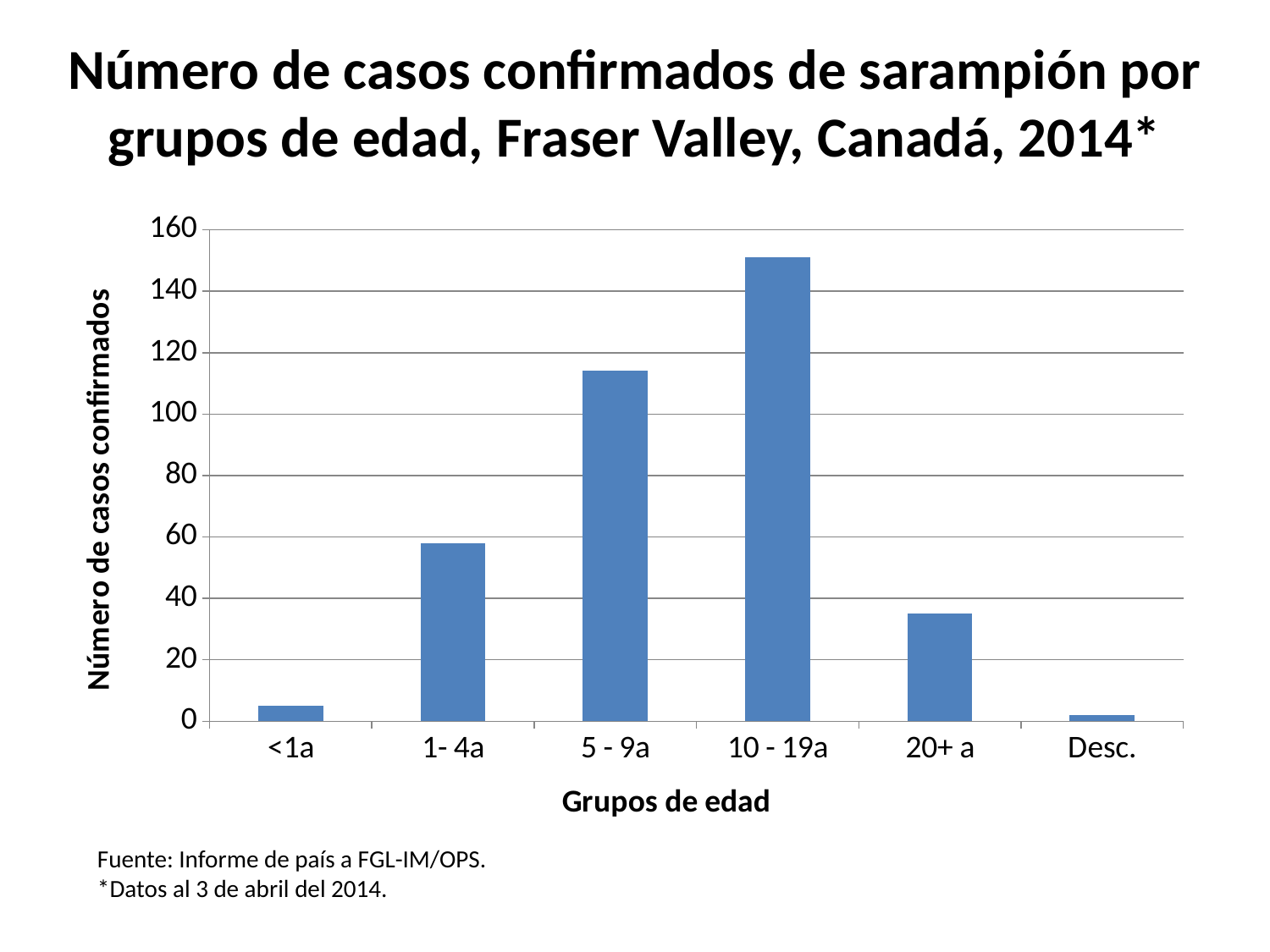
Is the value for <1a greater or less than 20? less Which age group has the lowest number of confirmed cases? Desc. Is the value for 20+ a greater or less than 40? less Which has more confirmed cases, 5 - 9a or 10 - 19a? 10 - 19a Is the value for 5 - 9a greater or less than 100? greater How many age groups are shown on the x axis? 6 What is the label of the y axis? Número de casos confirmados Which age group has the highest number of confirmed cases? 10 - 19a Which has more confirmed cases, 1- 4a or 20+ a? 1- 4a What kind of chart is shown on the slide? bar chart